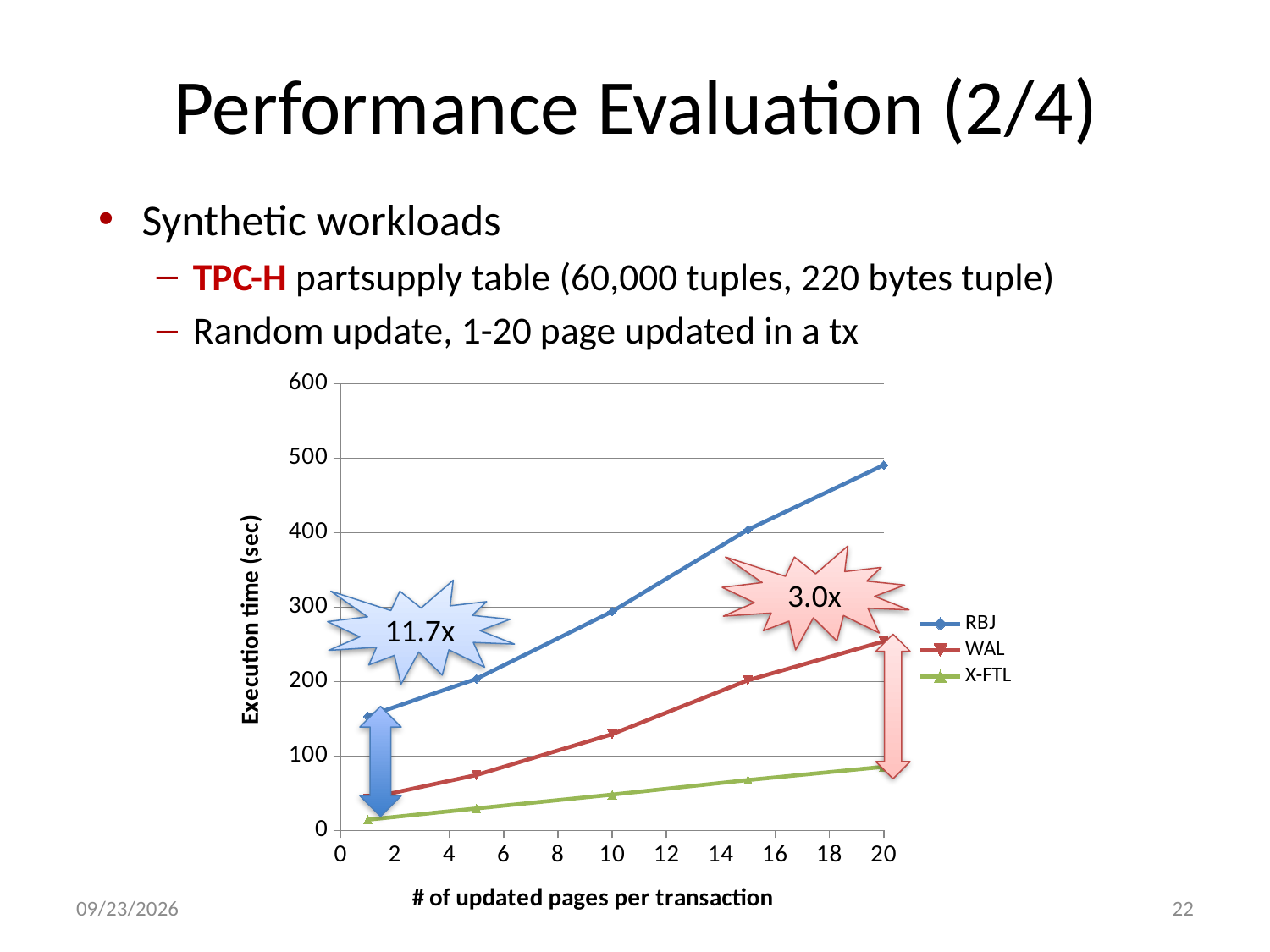
Does the execution time for RBJ rise or fall as the number of updated pages per transaction increases? rise How many data points are plotted for each series? 5 What is the label of the y axis? Execution time (sec) What kind of chart is shown on the slide? line chart Is the execution time for WAL at 10 updated pages greater or less than 200? less Is the execution time for X-FTL at 20 updated pages greater or less than 100? less Which series has the lowest execution time across the chart? X-FTL How many series does the legend list? 3 Is the execution time for RBJ at 20 updated pages greater or less than 400? greater What speedup factor is shown in the annotation near the right side of the chart? 3.0x At 15 updated pages per transaction, which series has the larger execution time, WAL or X-FTL? WAL Which series has the highest execution time at 20 updated pages per transaction? RBJ